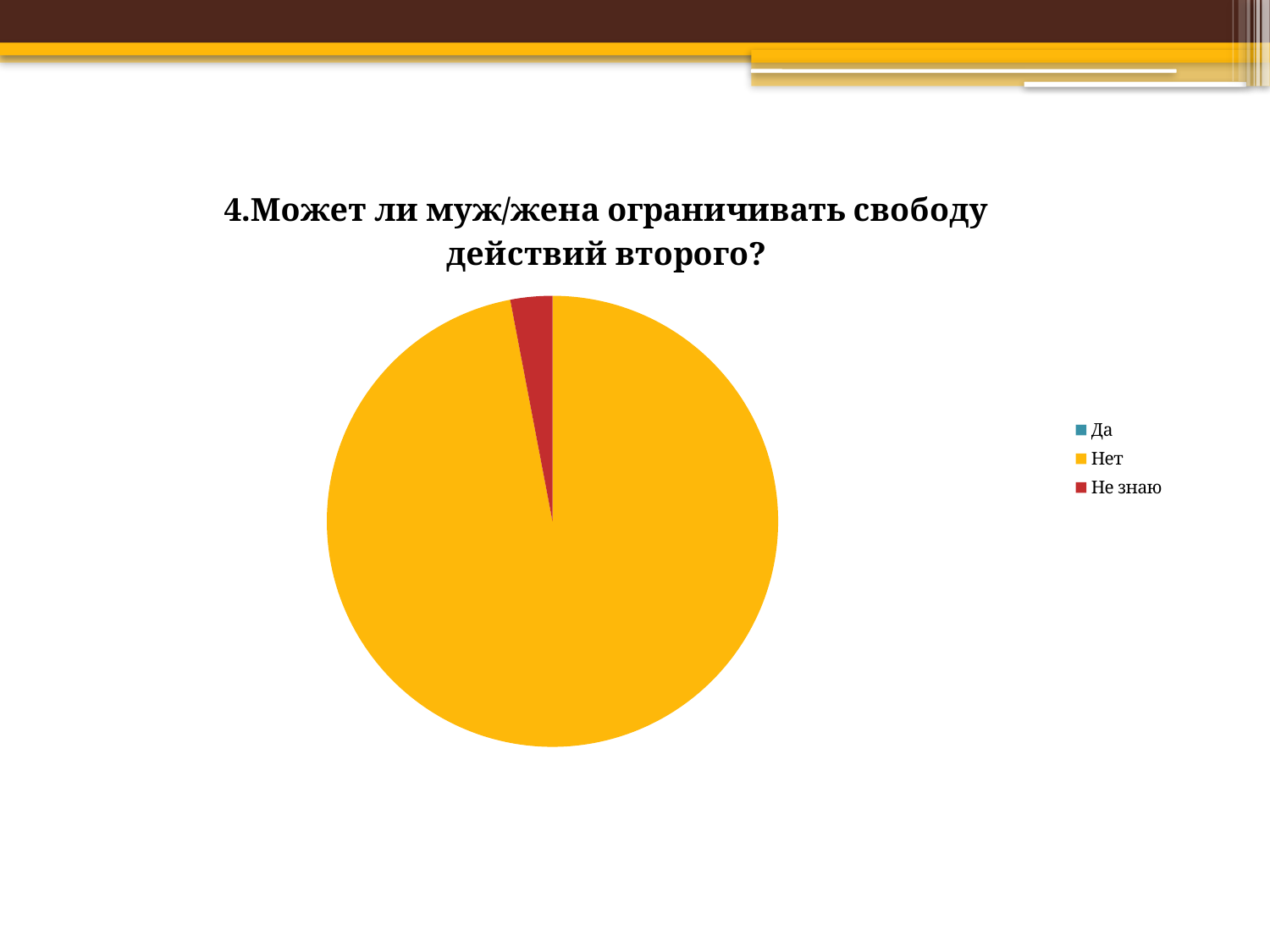
Which category has the largest slice of the pie? Нет Which colour represents Нет in the chart? yellow How many entries does the legend list? 3 Which category is represented by the small red slice? Не знаю Which is larger, the slice for Нет or the slice for Не знаю? Нет What is the title of the chart? 4.Может ли муж/жена ограничивать свободу действий второго? Does the slice for Нет take up more or less than half of the pie? more What kind of chart is shown on the slide? pie chart